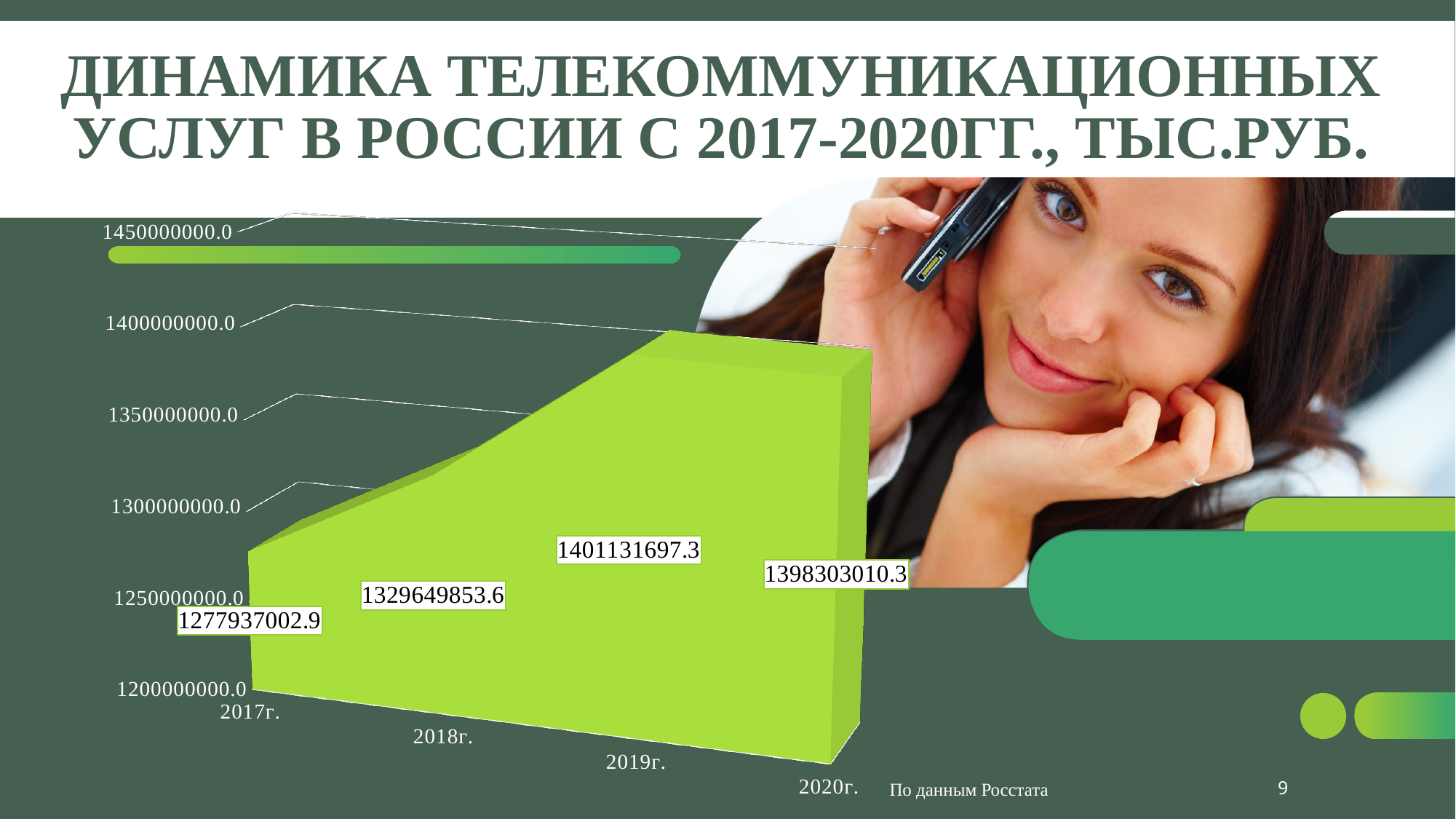
What is the difference between the values for 2018г. and 2017г.? 51712850.7 Which year has the lowest value? 2017г. Which year has the highest value? 2019г. What is the difference between the values for 2019г. and 2020г.? 2828687.0 What is the value for 2019г.? 1401131697.3 How many years are plotted on the chart? 4 What is the value for 2020г.? 1398303010.3 What is the value for 2018г.? 1329649853.6 What is the value for 2017г.? 1277937002.9 Which is larger, the value for 2019г. or the value for 2020г.? 2019г. What kind of chart is shown on the slide? 3D area chart Is the value for 2017г. greater or less than 1250000000.0? greater